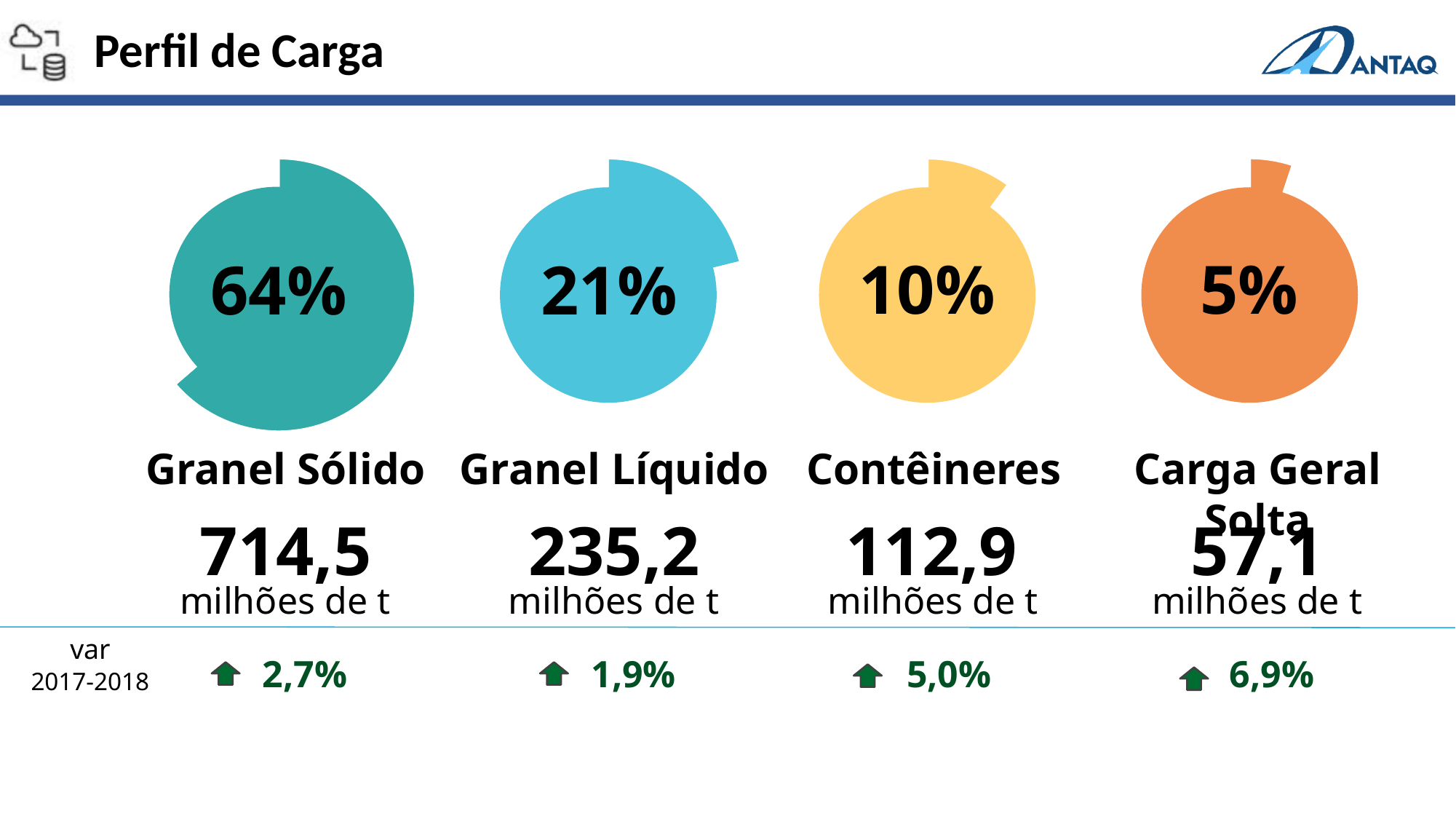
What is the difference in percentage points between the Granel Sólido share and the Granel Líquido share? 43 Which cargo type has the largest share? Granel Sólido What share of cargo does the Carga Geral Solta chart show? 5% What share of cargo does the Granel Sólido chart show? 64% What is the 2017-2018 variation shown for Carga Geral Solta? 6,9% What share of cargo does the Contêineres chart show? 10% How many millions of tonnes are shown for Contêineres? 112,9 How many cargo types are shown on the slide? 4 Which has the larger 2017-2018 variation, Granel Líquido or Contêineres? Contêineres How many millions of tonnes are shown for Granel Sólido? 714,5 Which cargo type has the smallest share? Carga Geral Solta